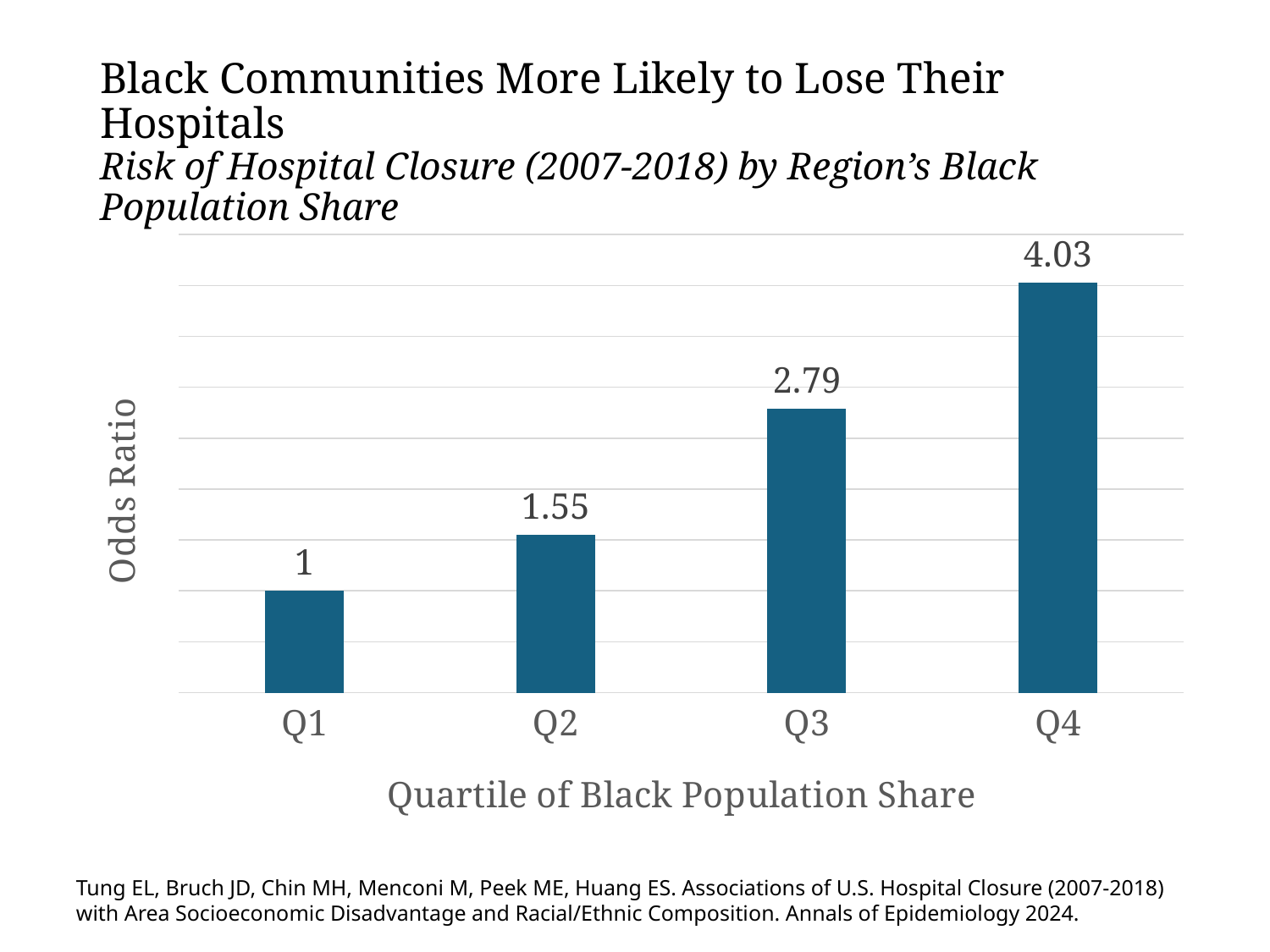
Which quartile has the highest odds ratio? Q4 What kind of chart is shown on the slide? Bar chart What is the odds ratio for Q3? 2.79 Do the odds ratios rise or fall from Q1 to Q4? Rise What is the odds ratio for Q4? 4.03 What is the difference between the odds ratios for Q4 and Q3? 1.24 How many quartiles are shown on the x axis? 4 Which quartile has the lowest odds ratio? Q1 What is the odds ratio for Q1? 1 What is the difference between the odds ratios for Q2 and Q1? 0.55 Which has a larger odds ratio, Q2 or Q3? Q3 What is the odds ratio for Q2? 1.55